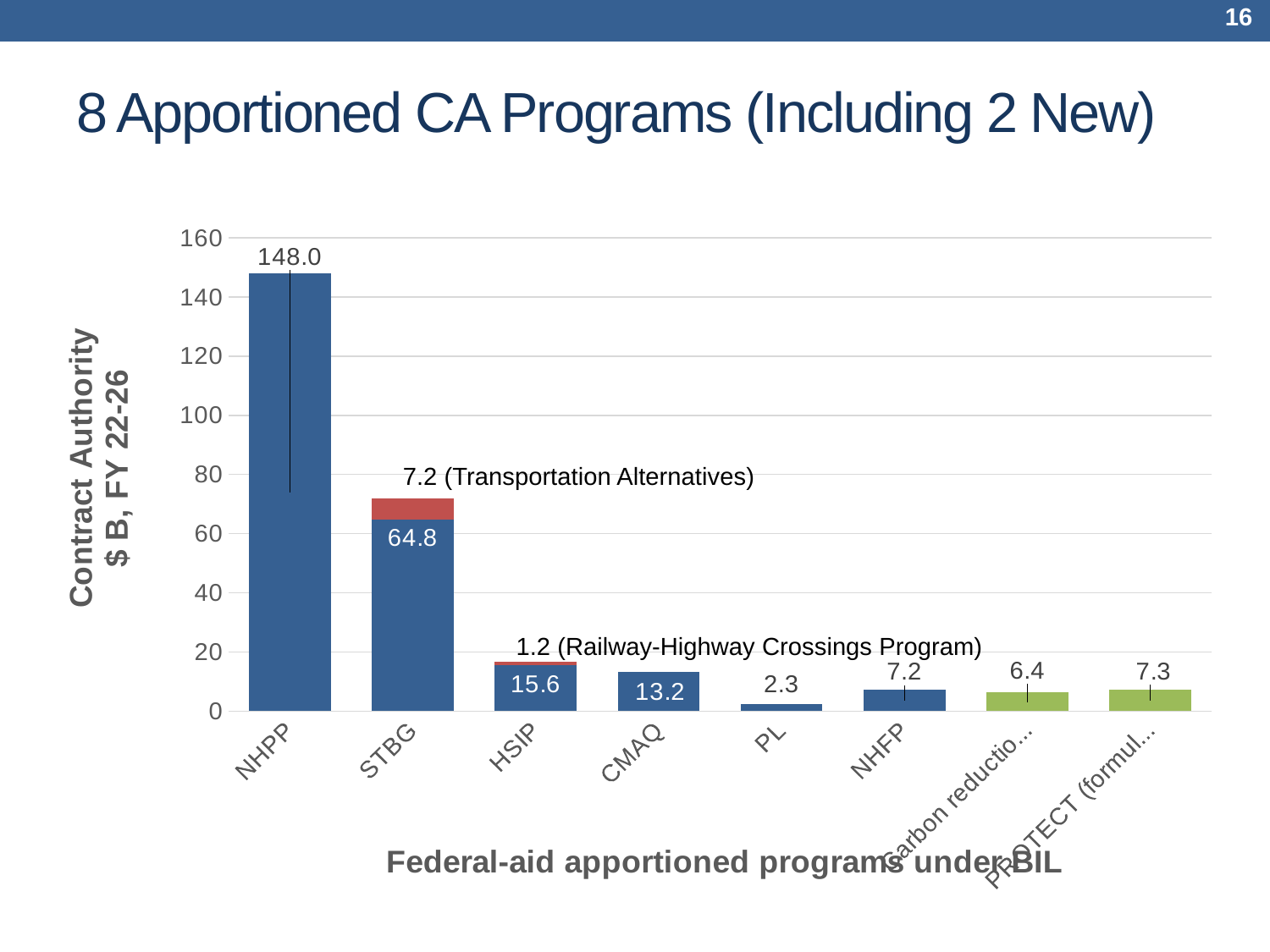
What is the y-axis title of the chart? Contract Authority $ B, FY 22-26 What is the value for NHPP? 148.0 What is the value for CMAQ? 13.2 What is the difference between the values for NHPP and CMAQ? 134.8 What is the value for PL? 2.3 Which program has the lowest contract authority? PL Which program has the highest contract authority? NHPP What is the total of the STBG bar including the Transportation Alternatives portion? 72.0 What is the value of the Transportation Alternatives portion stacked on the STBG bar? 7.2 How many programs (bars) are shown on the x axis? 8 What kind of chart is shown on the slide? bar chart Which is larger, the blue portion of HSIP or the value for CMAQ? HSIP